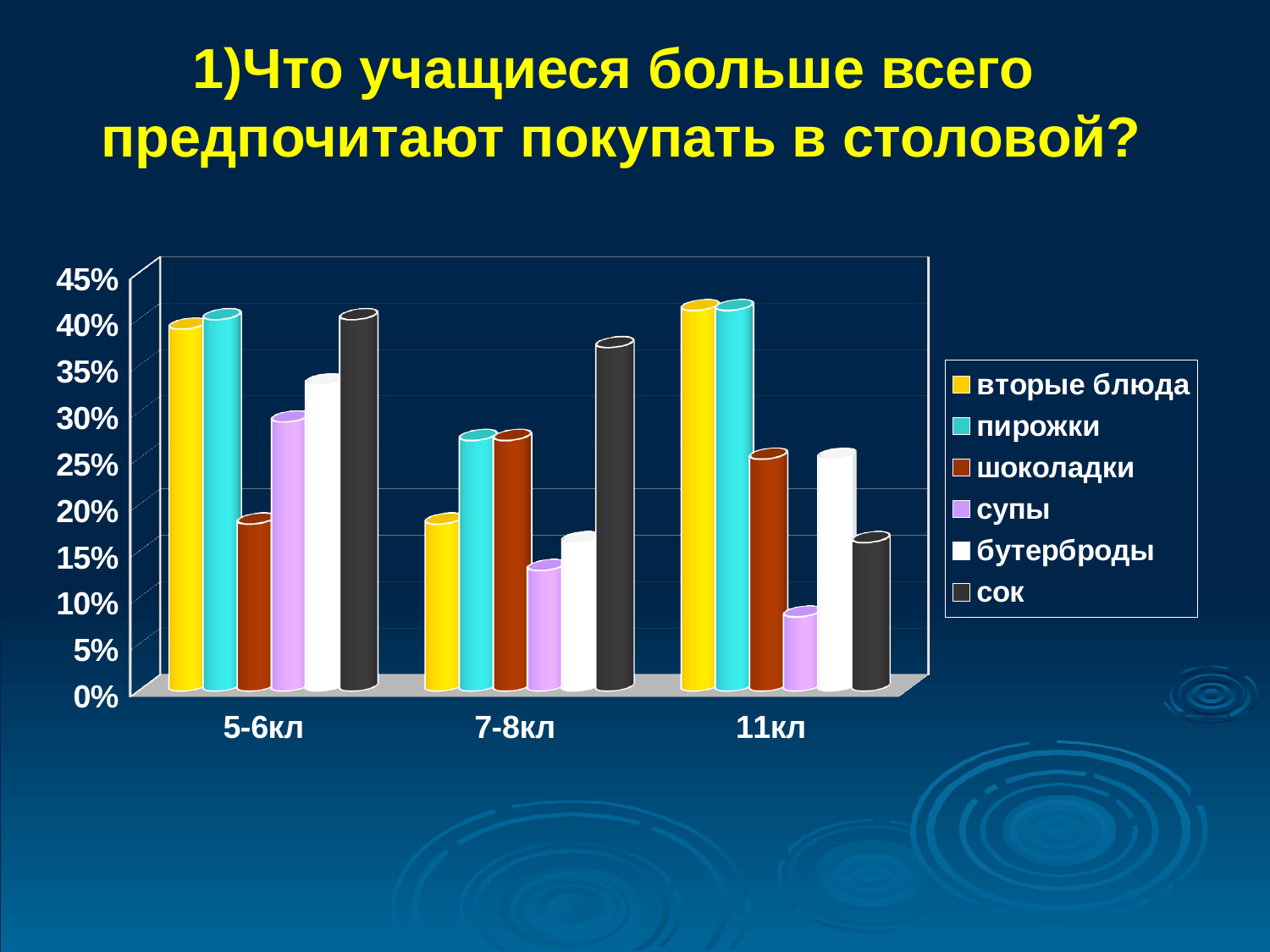
What kind of chart is shown on the slide? bar chart How many class groups are shown along the x axis? 3 Is the value for сок in the 7-8кл group greater or less than 35%? greater How many series does the legend list? 6 Which series is listed first in the legend? вторые блюда In the 7-8кл group, which is larger: сок or вторые блюда? сок Does the value for супы rise or fall from 5-6кл to 11кл? fall Is the value for бутерброды in the 5-6кл group greater or less than 30%? greater Which series has the lowest value in the 11кл group? супы Is the value for супы in the 11кл group greater or less than 10%? less Which series has the highest value in the 7-8кл group? сок